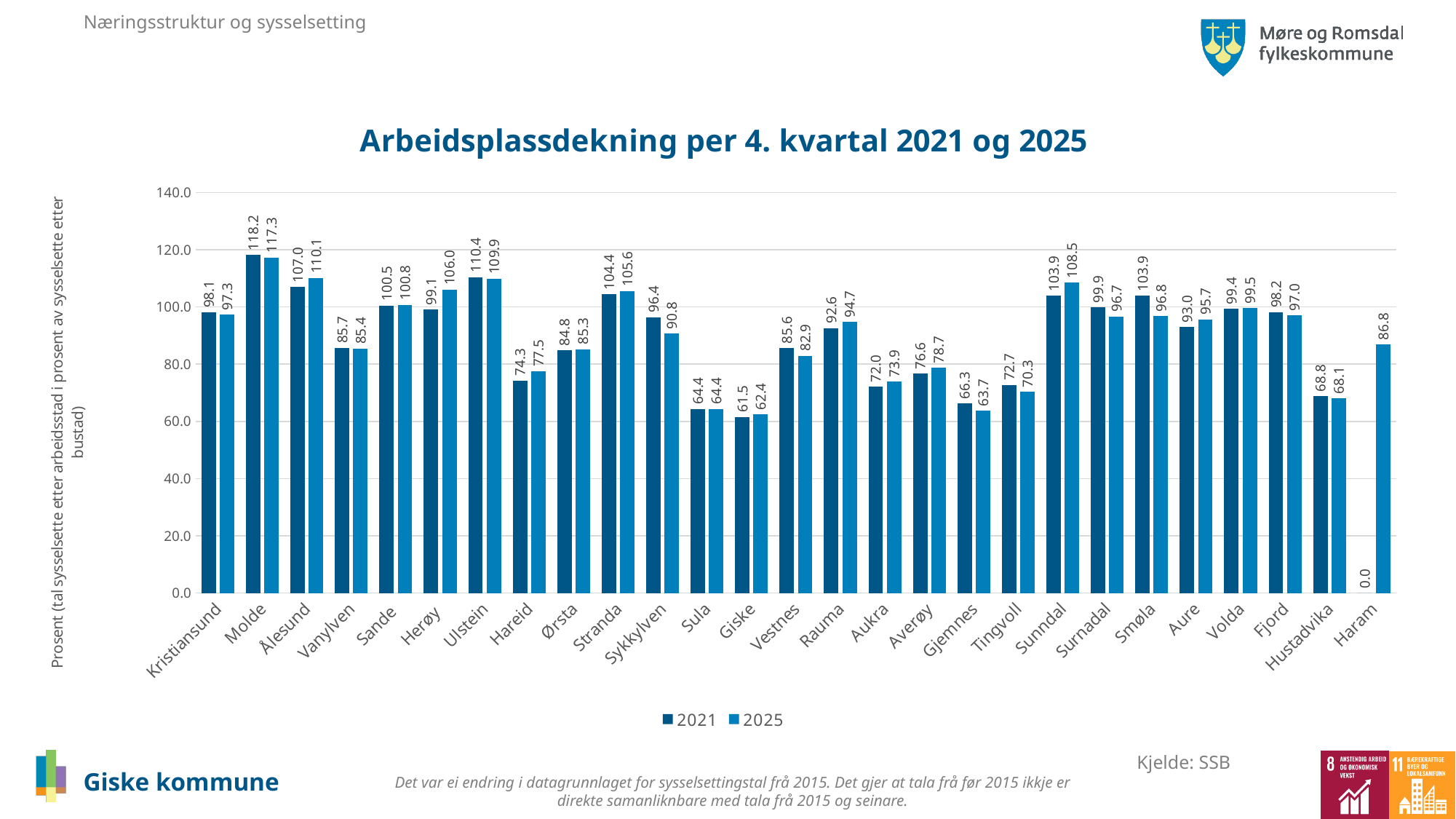
What is the title of the chart? Arbeidsplassdekning per 4. kvartal 2021 og 2025 Is the 2025 value for Sula greater or less than 80.0? less What is the 2025 value for Haram? 86.8 Which is larger for Sykkylven, the 2021 value or the 2025 value? 2021 What is the difference between the 2025 and 2021 values for Herøy? 6.9 How many series does the legend list? 2 Which municipality has the highest 2021 value? Molde What type of chart is shown on the slide? bar chart What is the 2025 value for Giske? 62.4 Which municipality has the lowest 2025 value? Giske What is the 2021 value for Sunndal? 103.9 How many municipalities are shown on the x axis? 27